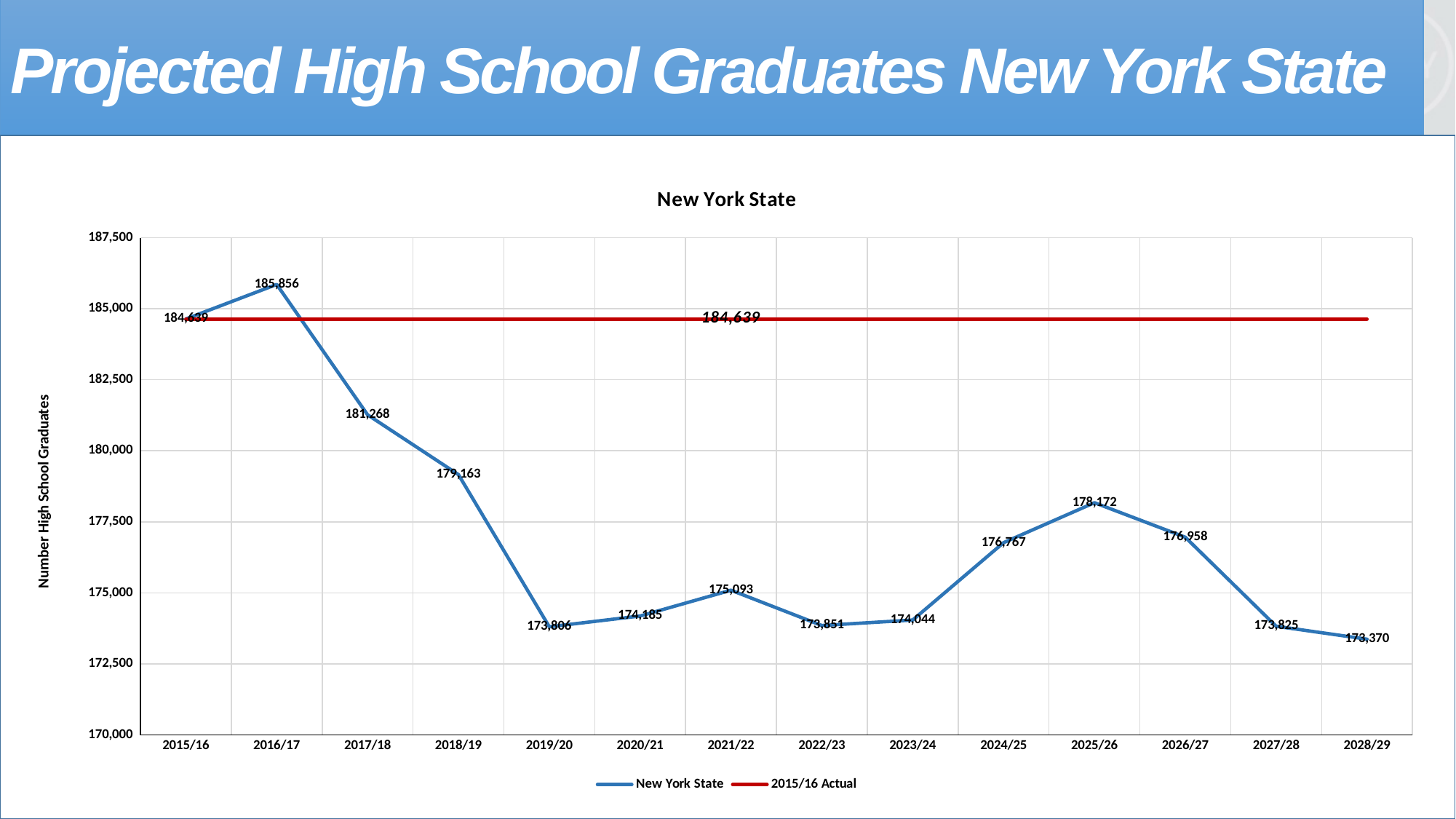
What value does the 2015/16 Actual line represent? 184,639 What kind of chart is shown on the slide? line chart Which year has the lowest number of high school graduates for New York State? 2028/29 What is the value for New York State in 2025/26? 178,172 Which is larger, the value for 2021/22 or the value for 2023/24? 2021/22 Which year has the highest number of high school graduates for New York State? 2016/17 How many series does the legend list? 2 Do the New York State values rise or fall from 2016/17 to 2019/20? fall How many school years are plotted on the x axis? 14 What is the projected number of high school graduates for New York State in 2017/18? 181,268 Is the value for 2018/19 greater or less than 180,000? less What is the difference between the 2016/17 value and the 2028/29 value for New York State? 12,486